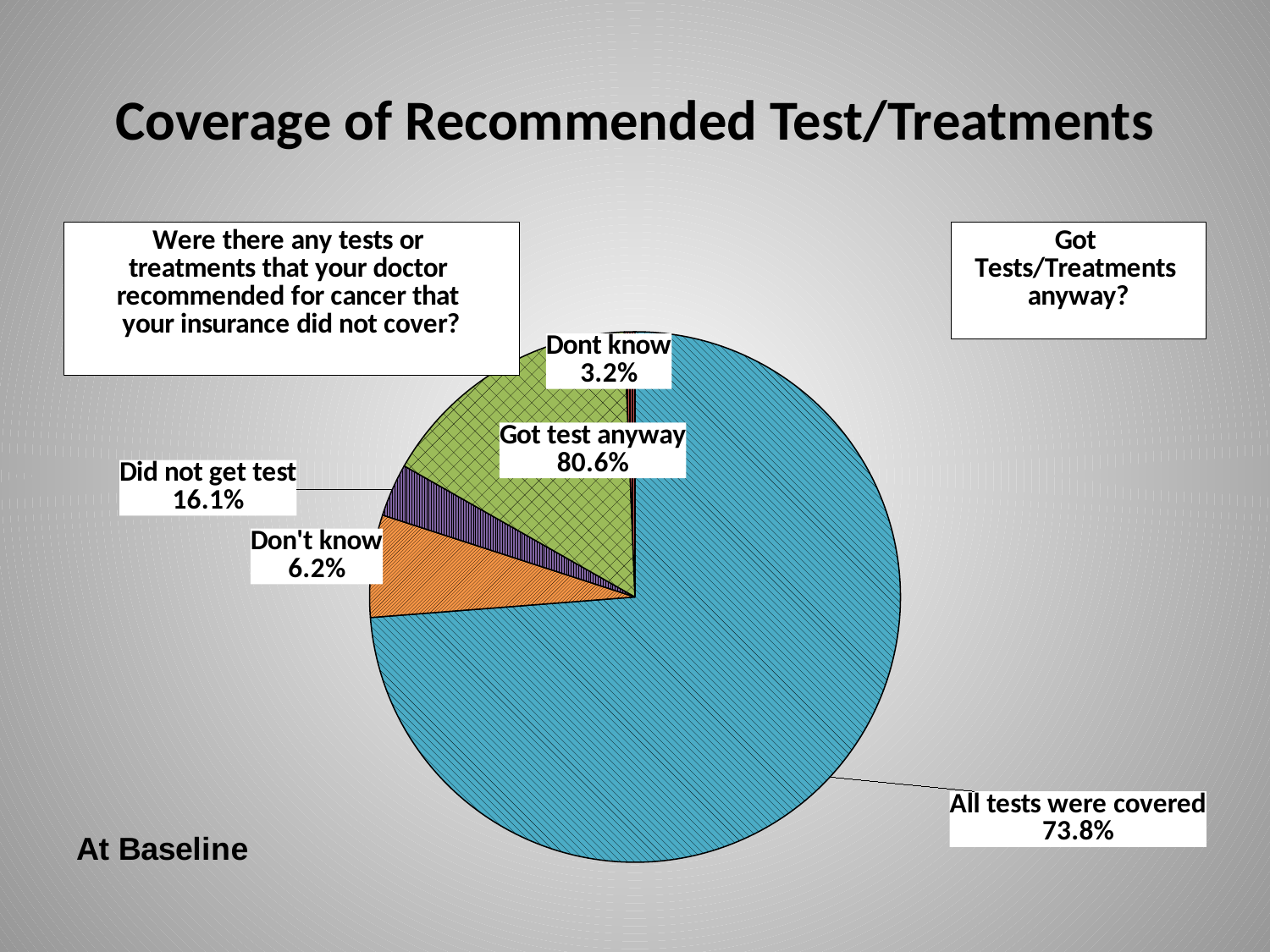
Which is larger: the value for 'All tests were covered' or the value for 'Don't know' (6.2%)? All tests were covered What percentage is shown for 'Don't know' next to the orange slice? 6.2% What is the difference between the 'All tests were covered' value (73.8%) and the 'Don't know' value (6.2%)? 67.6 percentage points What percentage is shown for 'Did not get test'? 16.1% What percentage is shown for 'Dont know' at the top of the pie? 3.2% What percentage is shown for 'All tests were covered'? 73.8% What is the title of the slide's chart? Coverage of Recommended Test/Treatments Which slice of the pie is the largest? All tests were covered What percentage is shown for 'Got test anyway'? 80.6% How many labelled slices does the pie chart have? 5 What type of chart is shown on the slide? Pie chart What time point does the text at the bottom left of the slide say the chart refers to? At Baseline